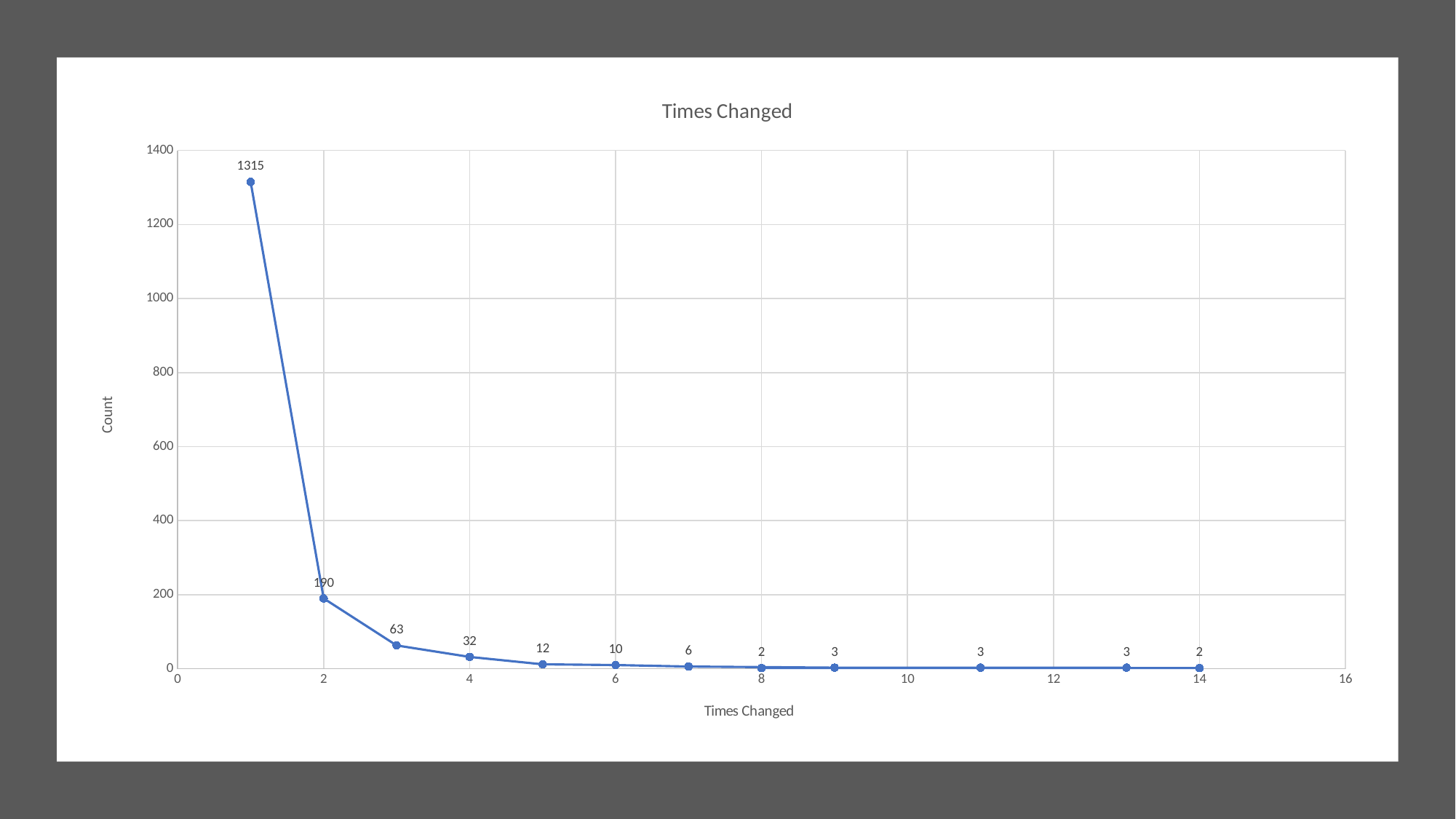
What is the difference between the count at Times Changed 1 and the count at Times Changed 2? 1125 What is the title of the chart? Times Changed At which value of Times Changed is the count highest? 1 Which is larger, the count at Times Changed 6 or the count at Times Changed 7? Times Changed 6 What is the count when Times Changed is 3? 63 What kind of chart is shown on the slide? line chart What is the count when Times Changed is 2? 190 Is the count at Times Changed 2 greater or less than 400? less What is the count when Times Changed is 1? 1315 What is the count when Times Changed is 5? 12 What is the difference between the count at Times Changed 3 and the count at Times Changed 4? 31 How many data points are plotted on the chart? 12